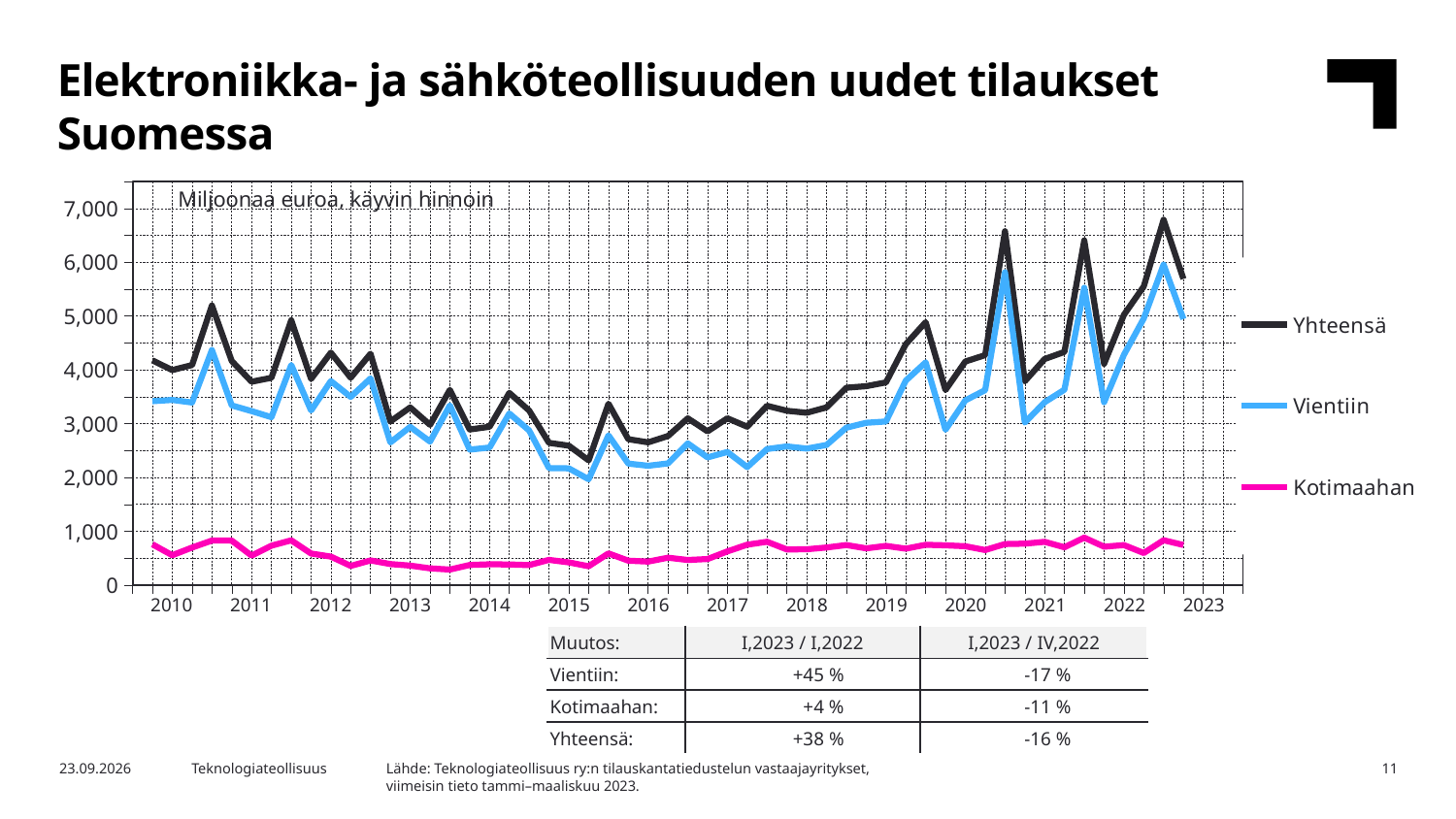
Which series has the highest values throughout the chart? Yhteensä Is the value for Yhteensä at the start of 2010 greater or less than 5,000? less Which is larger in 2021, the value for Yhteensä or the value for Kotimaahan? Yhteensä Does the Yhteensä series generally rise or fall between 2015 and 2022? rise Is the value for Kotimaahan at the start of 2010 greater or less than 1,000? less Is the value for Vientiin at the start of 2010 greater or less than 3,000? greater What unit label is shown inside the chart area? Miljoonaa euroa, käyvin hinnoin Which series are listed in the chart legend? Yhteensä, Vientiin, Kotimaahan What kind of chart is shown on the slide? line chart How many series does the legend list? 3 Which series has the lowest values throughout the chart? Kotimaahan